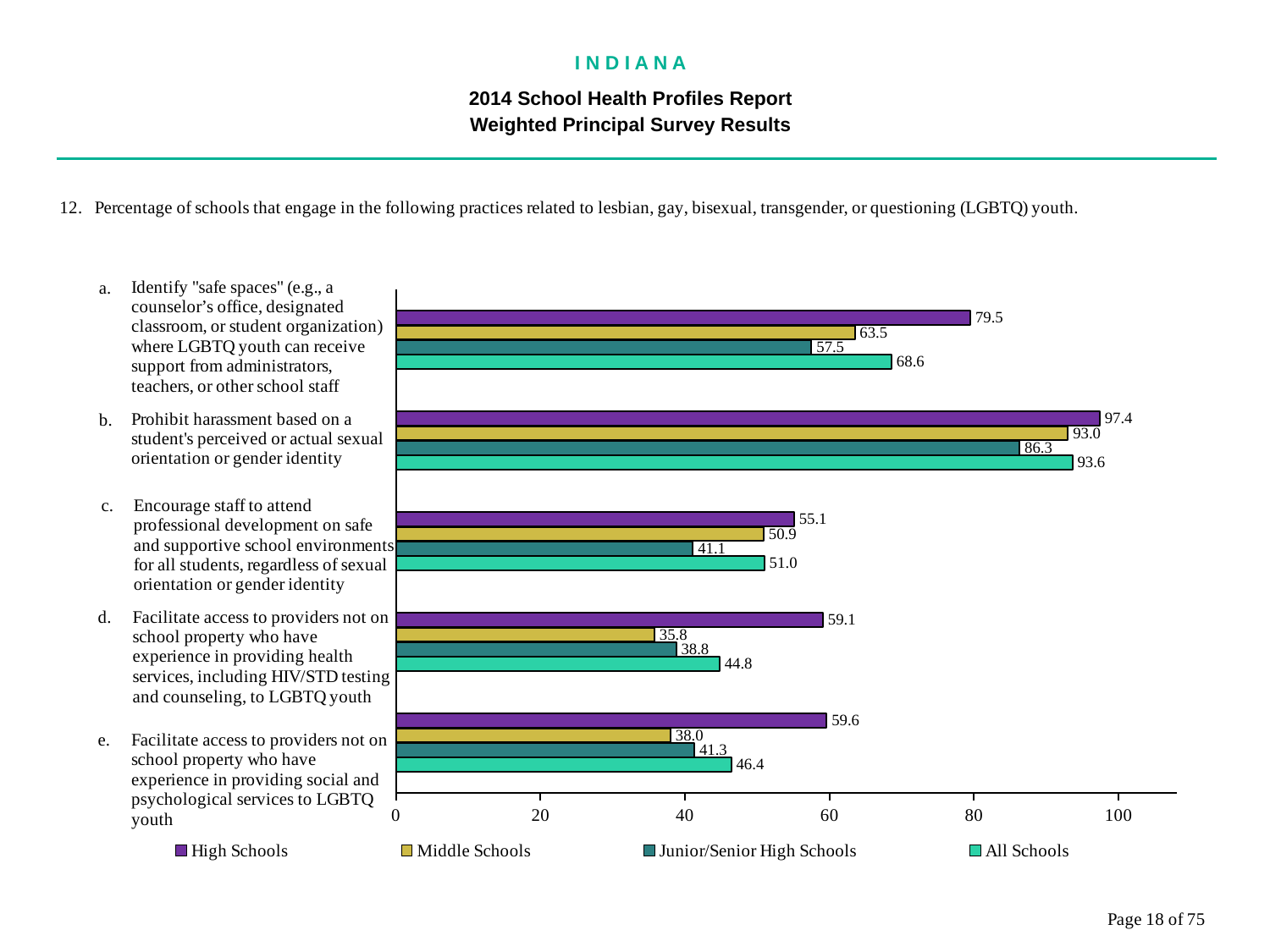
Which legend entry is shown in purple? High Schools How many series does the legend list? 4 What is the value for All Schools for practice e (facilitate access to providers for social and psychological services)? 46.4 What kind of chart is shown on the slide? Bar chart What is the difference between the High Schools and Middle Schools values for practice a (identify "safe spaces")? 16.0 How many practices (categories) are shown on the chart? 5 What is the value for High Schools for practice b (prohibit harassment based on a student's perceived or actual sexual orientation or gender identity)? 97.4 Which practice has the lowest value for Middle Schools? d. Facilitate access to providers not on school property who have experience in providing health services Which practice has the highest value for All Schools? b. Prohibit harassment based on a student's perceived or actual sexual orientation or gender identity What is the value for Junior/Senior High Schools for practice a (identify "safe spaces")? 57.5 What is the value for Middle Schools for practice d (facilitate access to providers not on school property who have experience in providing health services)? 35.8 For practice c (encourage staff to attend professional development), which is larger: the Middle Schools value or the Junior/Senior High Schools value? Middle Schools